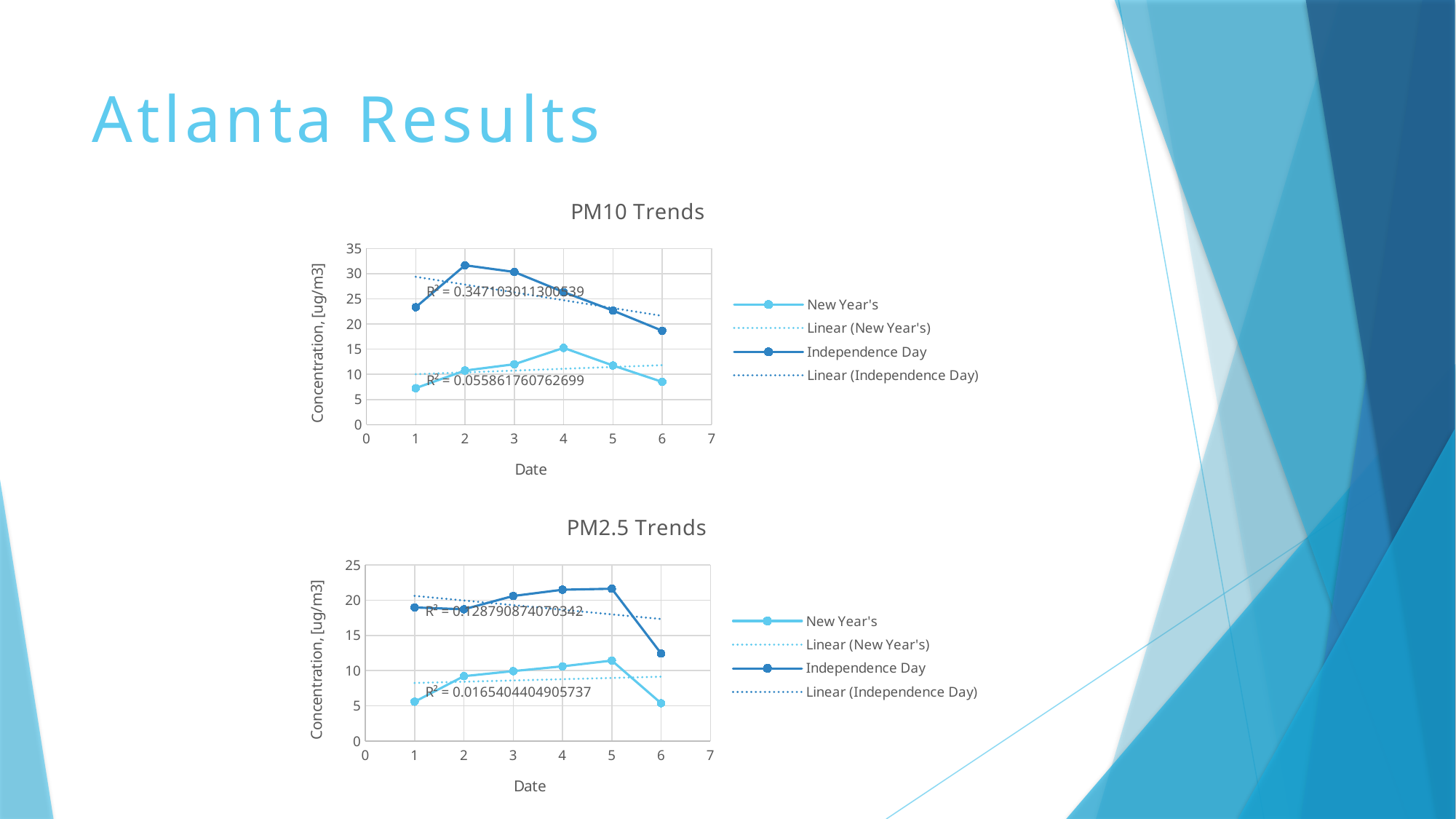
In the PM10 Trends chart, how many data points are plotted for the New Year's series? 6 In the PM2.5 Trends chart, is the Independence Day value at date 4 greater or less than 20? greater In the PM10 Trends chart, at which date does the Independence Day series reach its highest value? 2 In the PM10 Trends chart, what kind of chart is used to plot the data? line chart In the PM10 Trends chart, which series has the larger value at date 1, New Year's or Independence Day? Independence Day In the PM2.5 Trends chart, is the New Year's value at date 5 greater or less than 10? greater In the PM10 Trends chart, how many entries does the legend list? 4 In the PM10 Trends chart, is the Independence Day value at date 6 greater or less than 20? less In the PM10 Trends chart, do the Independence Day values rise or fall from date 2 to date 6? fall In the PM2.5 Trends chart, what is the title of the vertical axis? Concentration, [ug/m3] In the PM2.5 Trends chart, at which date does the Independence Day series have its lowest value? 6 In the PM10 Trends chart, at which date does the New Year's series reach its highest value? 4